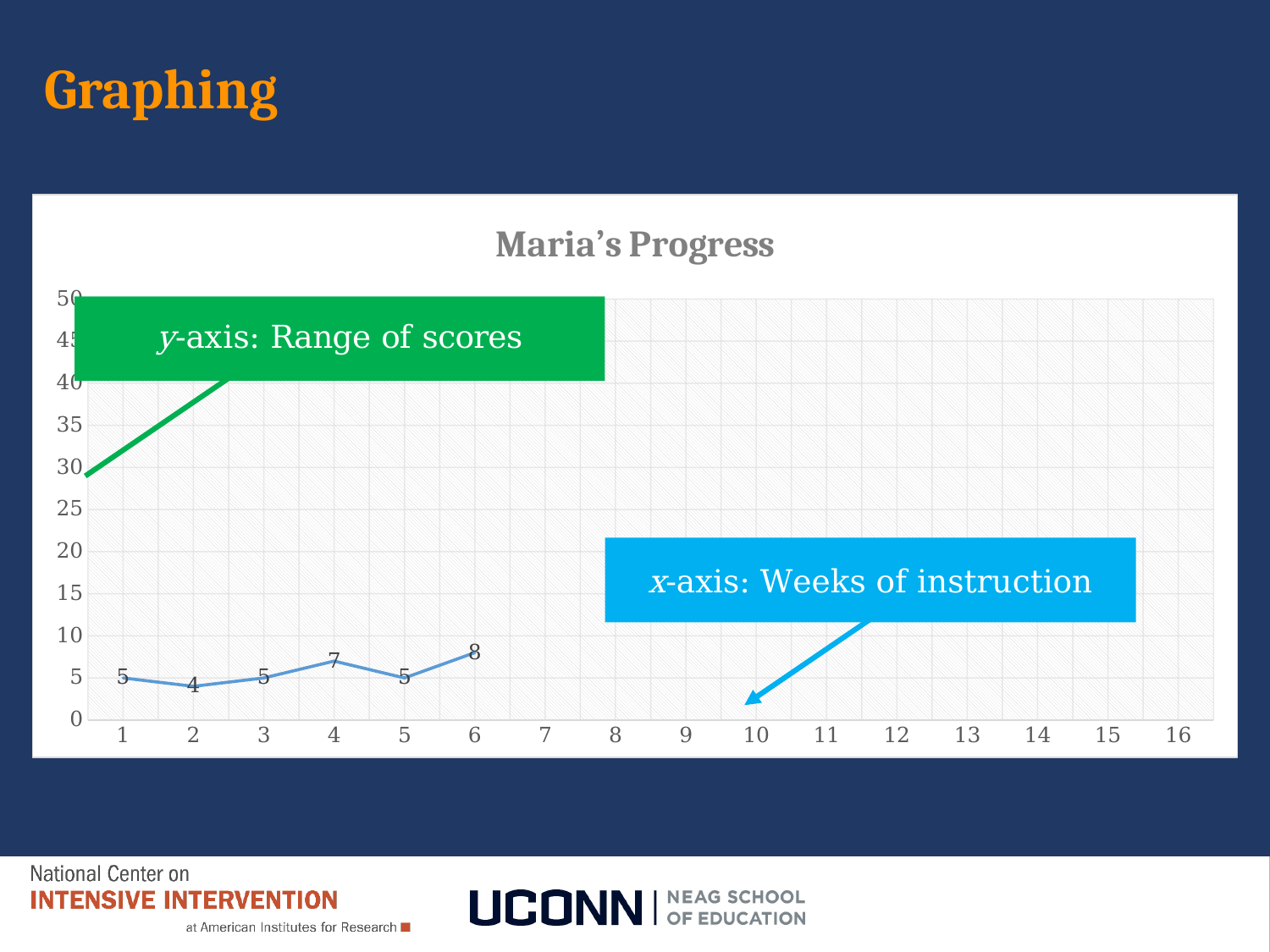
What is the title of the chart? Maria's Progress In which week is Maria's score highest? 6 What is Maria's score in week 2? 4 What is Maria's score in week 6? 8 What is Maria's score in week 1? 5 Which is larger, Maria's score in week 4 or her score in week 5? week 4 In which week is Maria's score lowest? 2 What is Maria's score in week 4? 7 How many weeks have a plotted score on the chart? 6 What is the difference between Maria's score in week 6 and her score in week 2? 4 What kind of chart is shown on the slide? line chart According to the label on the slide, what does the x-axis represent? Weeks of instruction